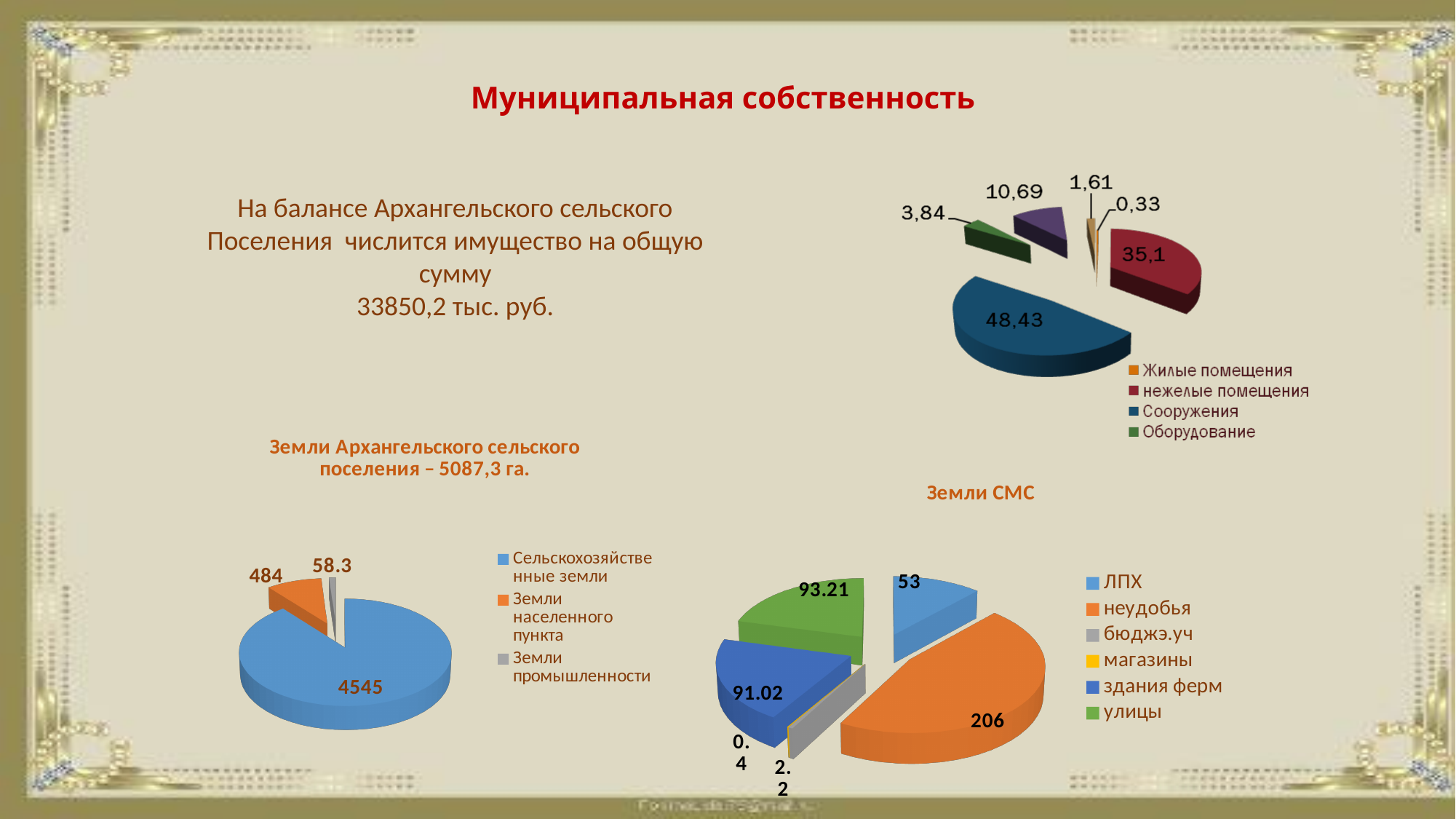
What type of chart is the top-right chart on the slide? Pie chart In the bottom-right chart 'Земли СМС', what is the difference between неудобья and ЛПХ? 153 In the bottom-right chart 'Земли СМС', which category has the largest value? неудобья In the bottom-left chart 'Земли Архангельского сельского поселения', what is the value for Сельскохозяйственные земли? 4545 In the bottom-right chart 'Земли СМС', what is the value for улицы? 93.21 In the bottom-left chart 'Земли Архангельского сельского поселения', how many categories does the legend list? 3 In the top-right pie chart, what is the value for Сооружения? 48,43 In the bottom-right chart 'Земли СМС', what is the value for неудобья? 206 In the bottom-left chart 'Земли Архангельского сельского поселения', which category has the smallest value? Земли промышленности In the bottom-right chart 'Земли СМС', how many categories does the legend list? 6 In the bottom-right chart 'Земли СМС', which is larger, здания ферм or ЛПХ? здания ферм In the bottom-left chart 'Земли Архангельского сельского поселения', what is the value for Земли населенного пункта? 484